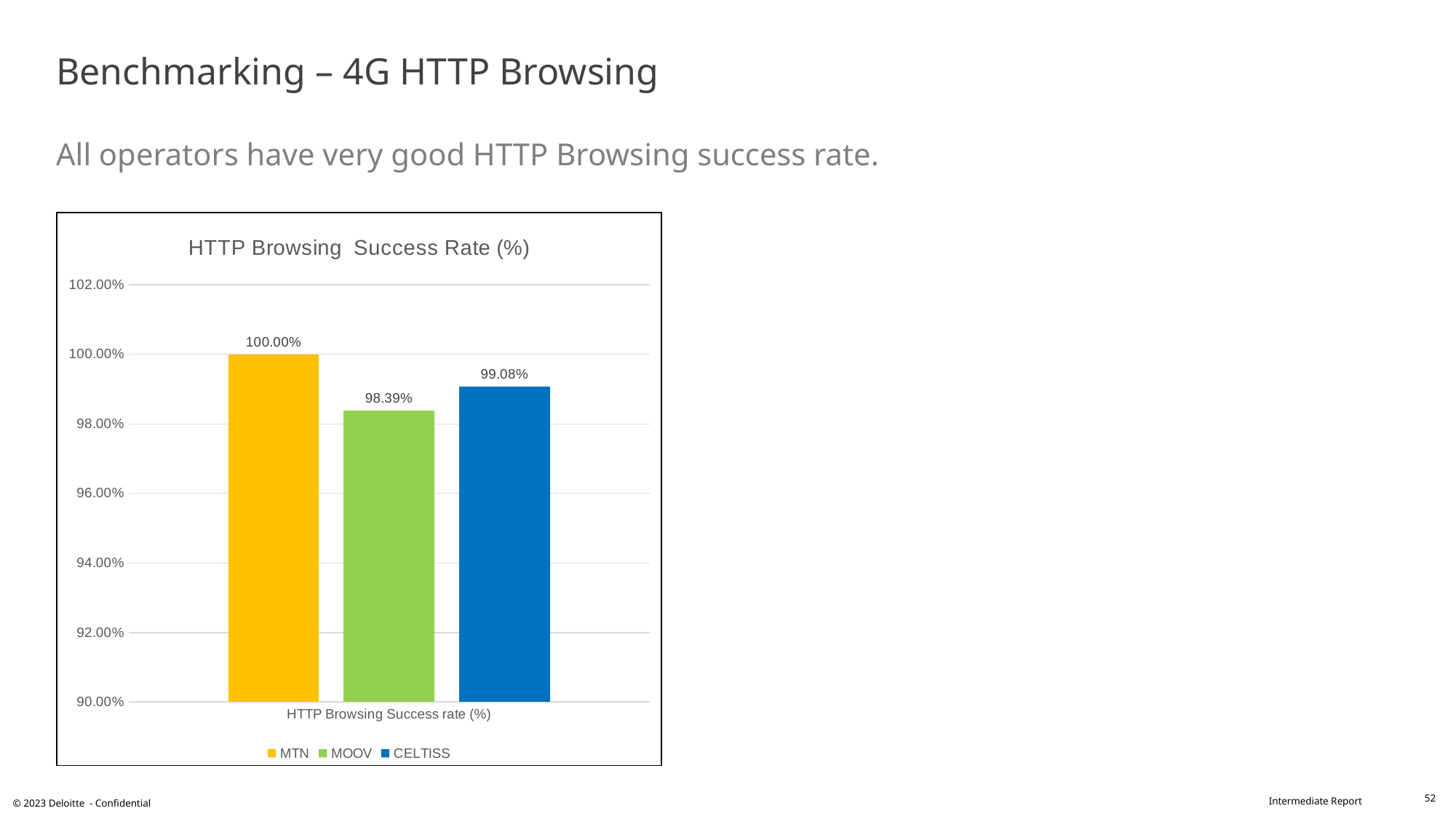
What is the difference between the HTTP Browsing success rates of MTN and MOOV? 1.61% How many series does the legend list? 3 What is the difference between the HTTP Browsing success rates of CELTISS and MOOV? 0.69% What is the HTTP Browsing success rate for MTN? 100.00% What is the HTTP Browsing success rate for MOOV? 98.39% Which operator has the highest HTTP Browsing success rate? MTN Which has a higher HTTP Browsing success rate, MOOV or CELTISS? CELTISS Which operator has the lowest HTTP Browsing success rate? MOOV What is the HTTP Browsing success rate for CELTISS? 99.08% What is the title of the chart? HTTP Browsing Success Rate (%) Is the HTTP Browsing success rate for MOOV greater or less than 98.00%? greater What kind of chart is shown on the slide? Bar chart